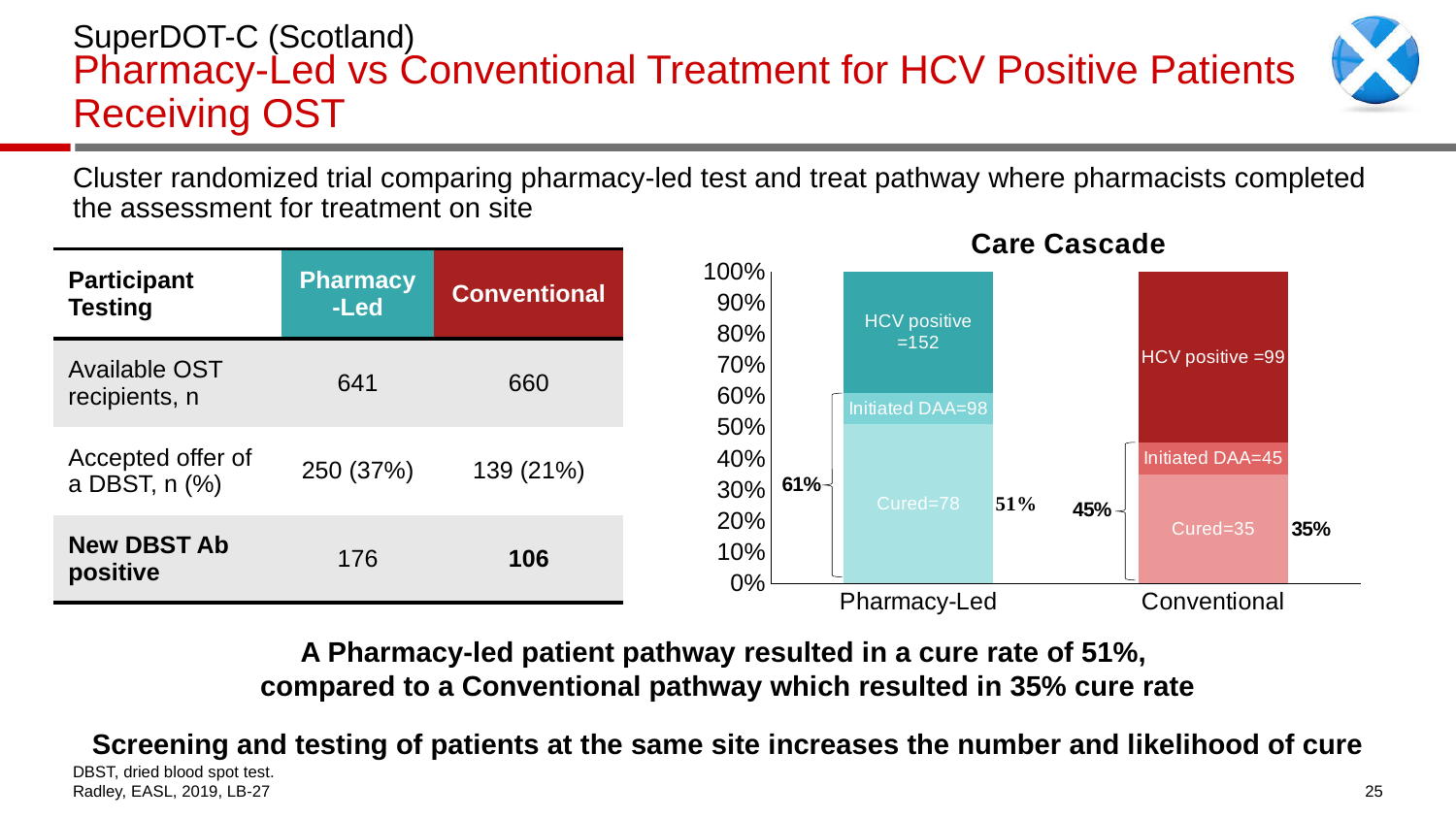
In the Care Cascade chart, how many patients were cured in the Pharmacy-Led group? 78 In the Care Cascade chart, what is the difference between the number of patients who initiated DAA in the Pharmacy-Led group and in the Conventional group? 53 In the Care Cascade chart, how many patients were HCV positive in the Conventional group? 99 In the Care Cascade chart, how many patients were HCV positive in the Pharmacy-Led group? 152 In the Care Cascade chart, which group has the higher number of cured patients, Pharmacy-Led or Conventional? Pharmacy-Led How many categories are shown on the x axis of the Care Cascade chart? 2 In the Care Cascade chart, how many patients initiated DAA in the Conventional group? 45 What is the title of the chart on the slide? Care Cascade In the Care Cascade chart, is the Initiated DAA bar for the Conventional group greater or less than 50%? less In the Care Cascade chart, what percentage is shown next to the Cured bar for the Conventional group? 35% In the Care Cascade chart, what percentage is shown for Initiated DAA in the Pharmacy-Led group? 61% What type of chart is the Care Cascade chart? bar chart